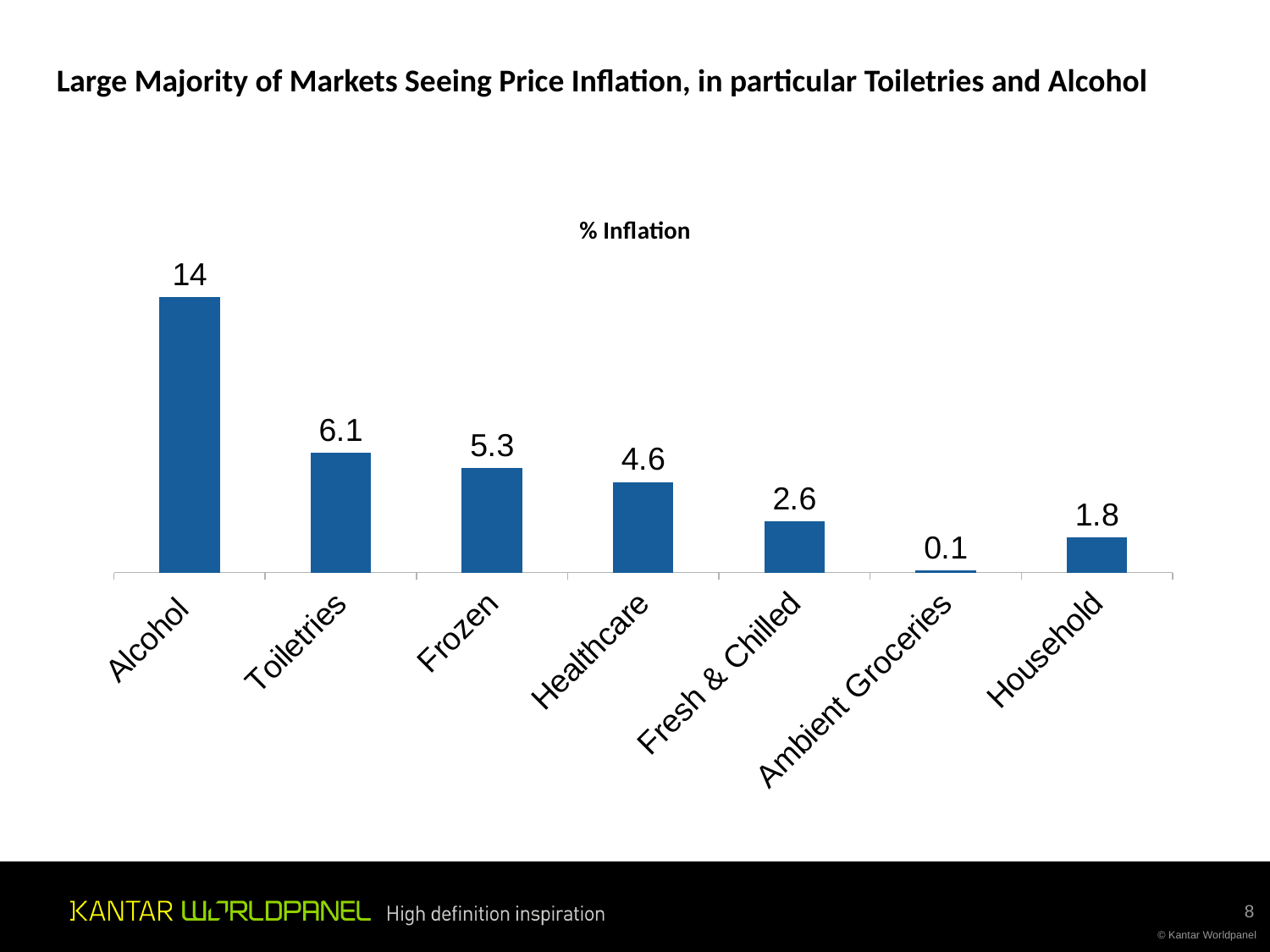
What is the % Inflation value for Toiletries? 6.1 Which has a higher % Inflation, Fresh & Chilled or Household? Fresh & Chilled What is the % Inflation value for Alcohol? 14 What kind of chart is shown on the slide? Bar chart How many categories are shown in the chart? 7 What is the title of the chart? % Inflation What is the % Inflation value for Ambient Groceries? 0.1 Which category has the highest % Inflation? Alcohol What is the difference in % Inflation between Frozen and Healthcare? 0.7 What is the difference in % Inflation between Alcohol and Toiletries? 7.9 What is the % Inflation value for Household? 1.8 Which category has the lowest % Inflation? Ambient Groceries